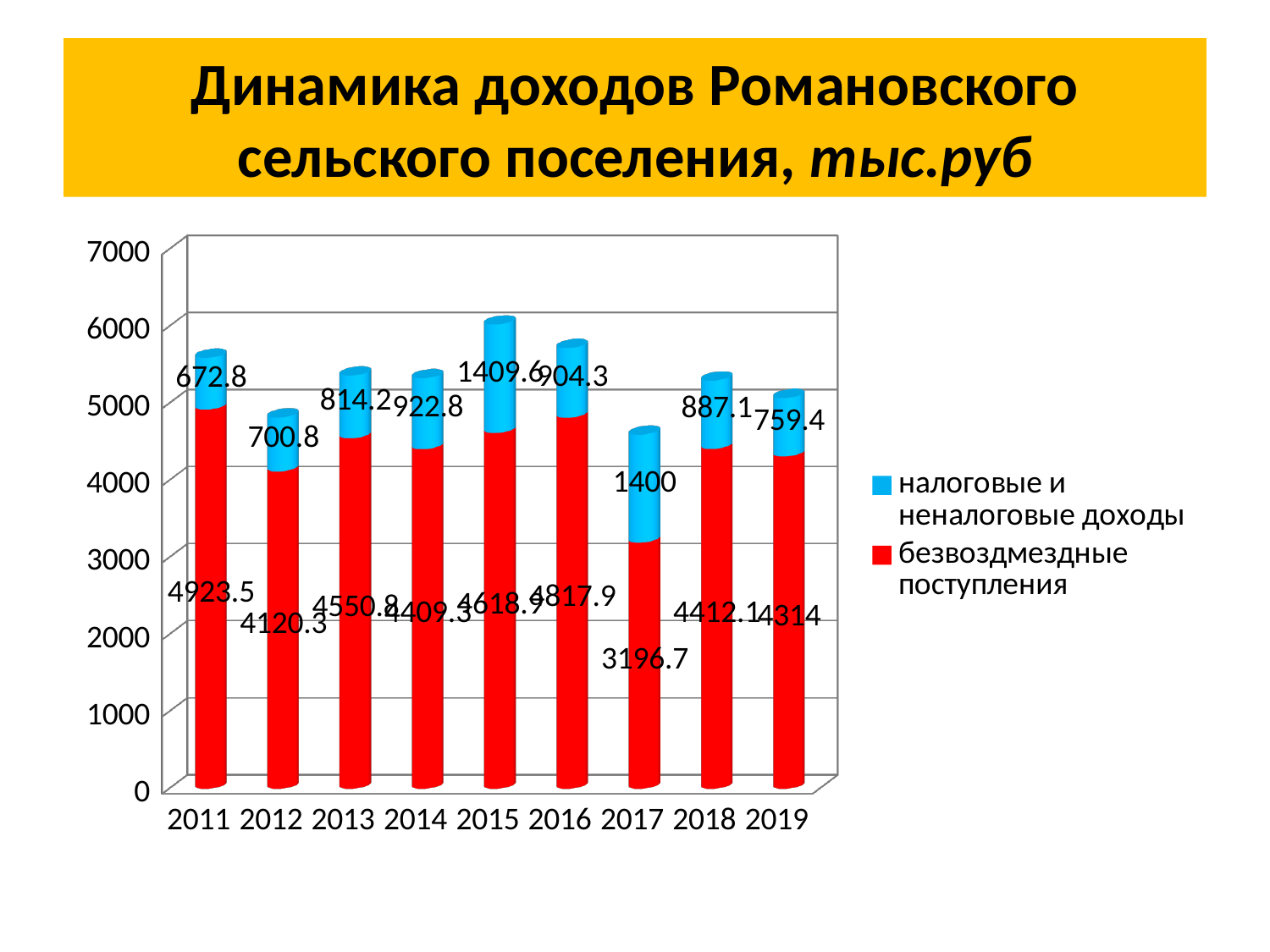
What type of chart is shown on the slide? stacked bar chart Which is larger: налоговые и неналоговые доходы in 2014 or in 2018? 2014 In which year is безвозмездные поступления the lowest? 2017 What is the total of the stacked bar for 2015? 6028.5 What is the value of безвозмездные поступления in 2019? 4314 What is the value of налоговые и неналоговые доходы in 2017? 1400 How many series does the legend list? 2 What is the value of безвозмездные поступления in 2011? 4923.5 How many years are shown on the x axis? 9 In which year is безвозмездные поступления the highest? 2011 What is the difference between безвозмездные поступления in 2011 and in 2012? 803.2 In which year is налоговые и неналоговые доходы the lowest? 2011